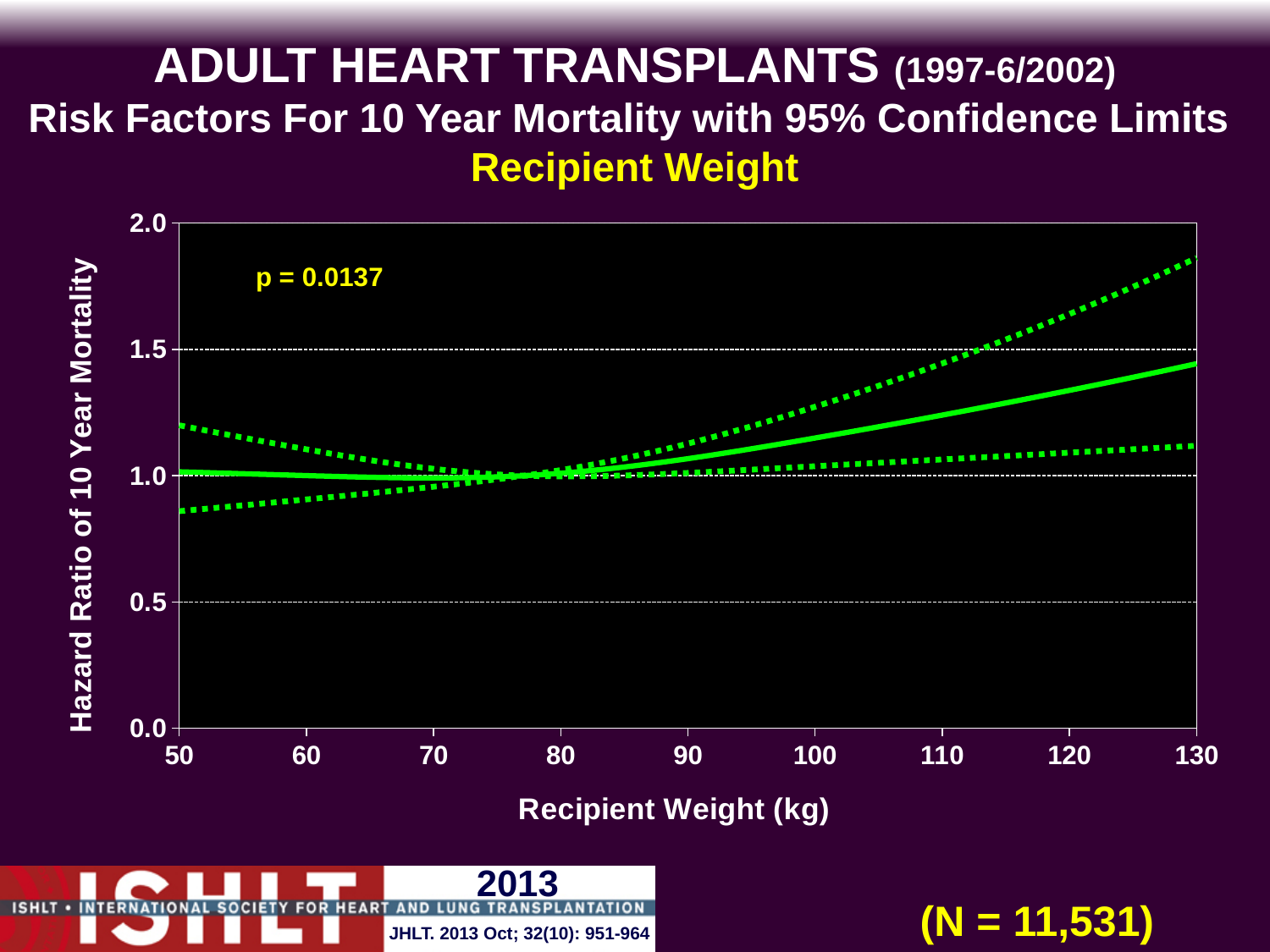
Does the lower dotted confidence limit rise or fall as recipient weight increases from 50 kg to 130 kg? rise How many tick labels are shown on the x axis (Recipient Weight)? 9 What is the sample size (N) shown on the slide? N = 11,531 Is the value of the upper dotted confidence limit at 130 kg greater or less than 1.5? greater What is the p-value printed on the chart? p = 0.0137 Is the value of the lower dotted confidence limit at 50 kg greater or less than 1.0? less What kind of chart is shown on the slide? line chart Does the solid hazard ratio line rise or fall as recipient weight increases from 80 kg to 130 kg? rise Is the value of the solid hazard ratio line at 100 kg greater or less than 1.0? greater